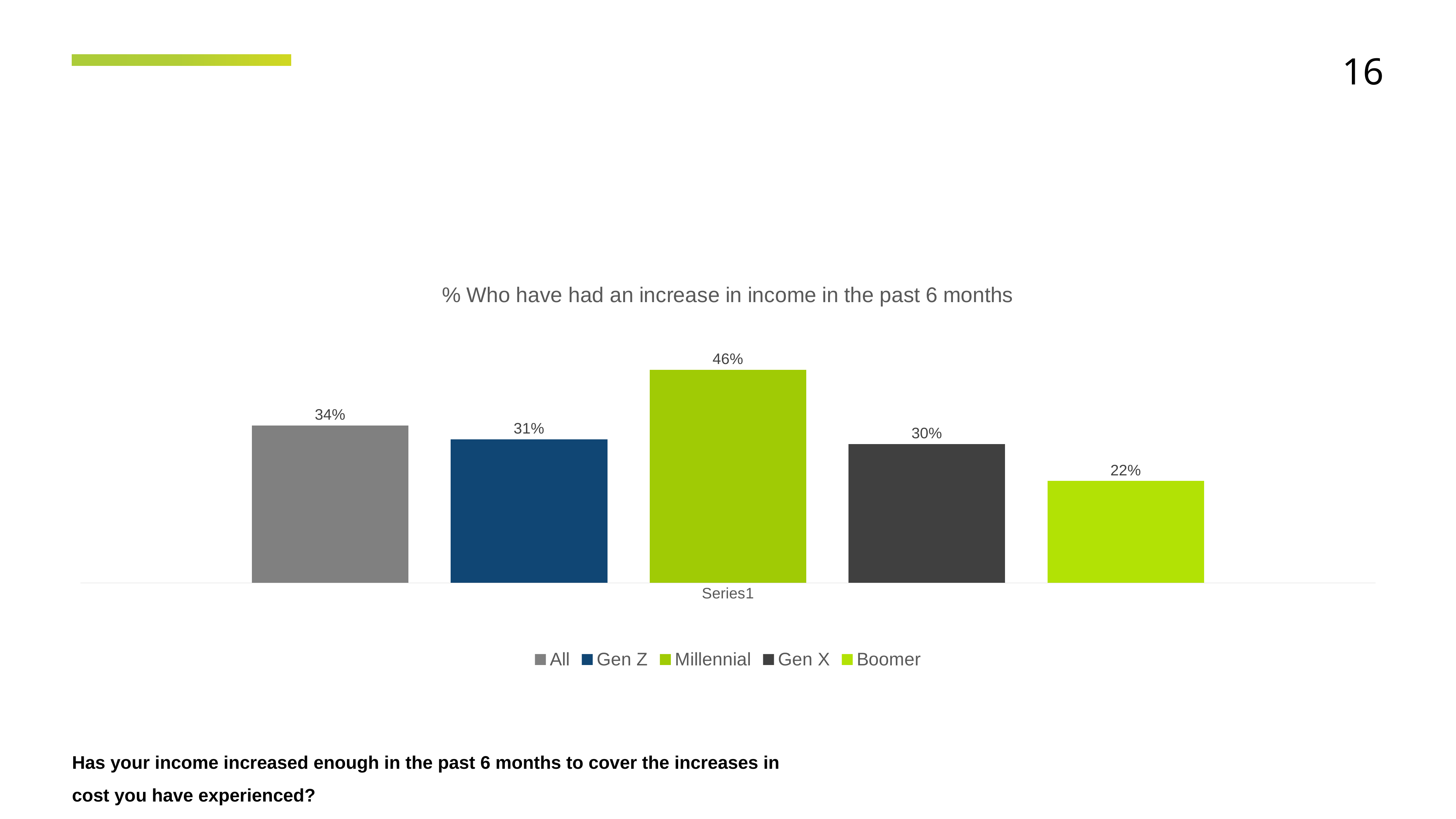
Which is larger, the value for Gen Z or the value for Boomer? Gen Z Which group has the highest value? Millennial Which group has the lowest value? Boomer How many entries does the legend list? 5 What kind of chart is shown? Bar chart What is the difference between the Millennial and Boomer values? 24% What is the value for All? 34% What is the difference between the All and Gen X values? 4% How many bars are plotted in the chart? 5 What is the value for Gen Z? 31% What is the value for Millennial? 46% What is the value for Boomer? 22%